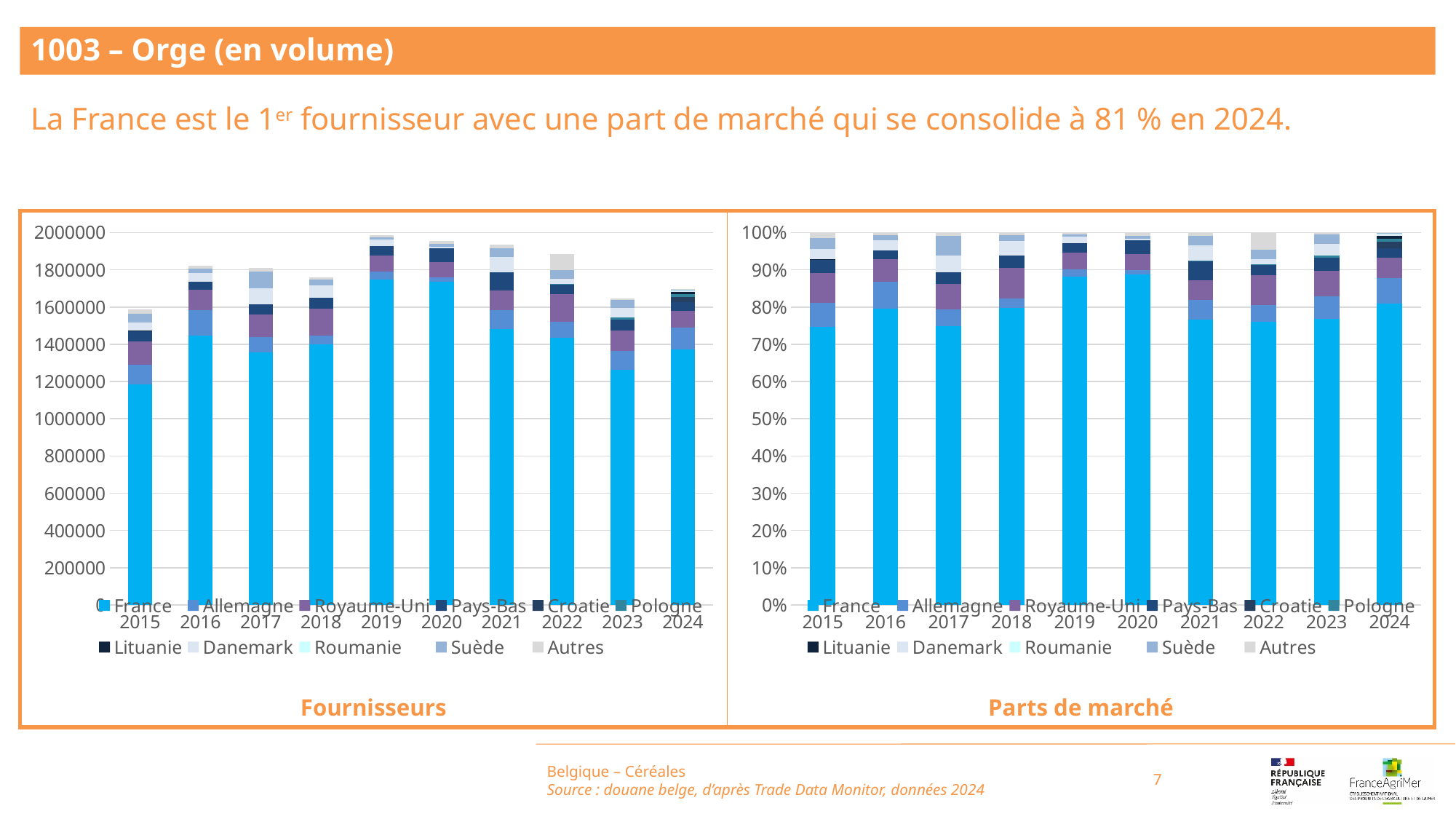
In the 'Fournisseurs' chart, which year has the highest total stacked bar? 2019 In the 'Parts de marché' chart, which is larger: the share for France in 2019 or in 2015? 2019 How many years are shown on the x axis of the 'Parts de marché' chart? 10 How many series does the legend of the 'Fournisseurs' chart list? 11 What kind of chart is the 'Fournisseurs' chart on the left? Stacked bar chart In the 'Parts de marché' chart, is the share for France in 2019 greater or less than 80%? greater In the 'Fournisseurs' chart, which year has the lowest total stacked bar? 2015 In the 'Fournisseurs' chart, is the total bar for 2019 greater or less than 1800000? greater What is the title shown under the right-hand chart? Parts de marché In the 'Parts de marché' chart, is the share for France in 2015 greater or less than 80%? less In the 'Parts de marché' chart, does the share for France rise or fall from 2015 to 2019? rise